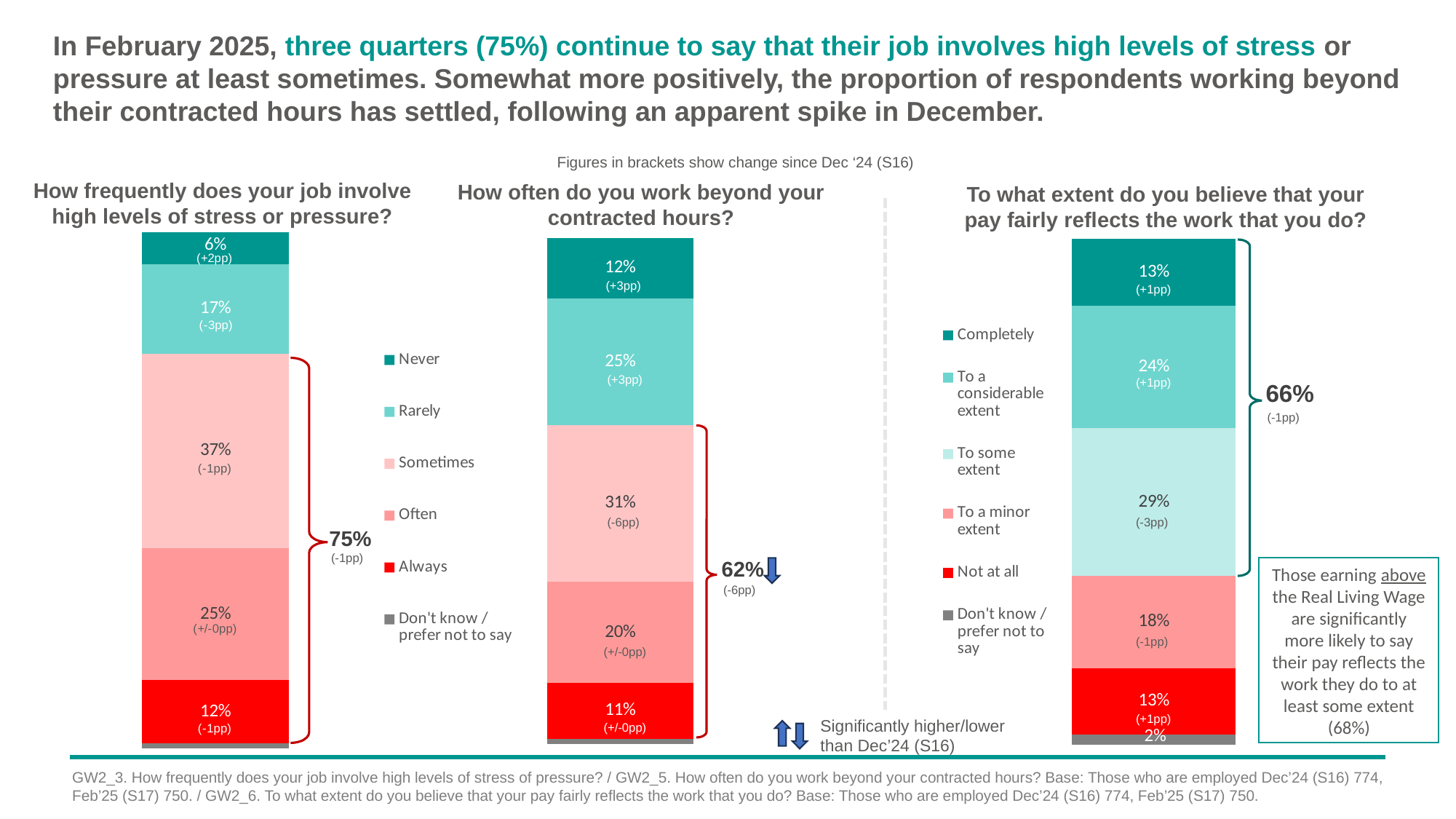
In the chart 'How often do you work beyond your contracted hours?', what is the difference between the Sometimes and Often percentages? 11 percentage points In the chart 'How often do you work beyond your contracted hours?', what percentage answered Rarely? 25% How many response categories does the legend list for the chart 'How often do you work beyond your contracted hours?' 6 In the chart 'How frequently does your job involve high levels of stress or pressure?', which response category has the largest share? Sometimes In the chart 'How frequently does your job involve high levels of stress or pressure?', what percentage answered Sometimes? 37% In the chart 'To what extent do you believe that your pay fairly reflects the work that you do?', which is larger: To a considerable extent or To a minor extent? To a considerable extent In the chart 'How often do you work beyond your contracted hours?', what is the change since Dec '24 shown for the Sometimes segment? -6pp In the chart 'To what extent do you believe that your pay fairly reflects the work that you do?', what percentage answered Not at all? 13% What type of chart is used to show the responses on this slide? Stacked bar chart In the chart 'To what extent do you believe that your pay fairly reflects the work that you do?', what percentage answered To some extent? 29% In the chart 'How frequently does your job involve high levels of stress or pressure?', what percentage answered Always? 12% In the chart 'To what extent do you believe that your pay fairly reflects the work that you do?', what combined percentage is shown by the bracket for Completely, To a considerable extent and To some extent? 66%